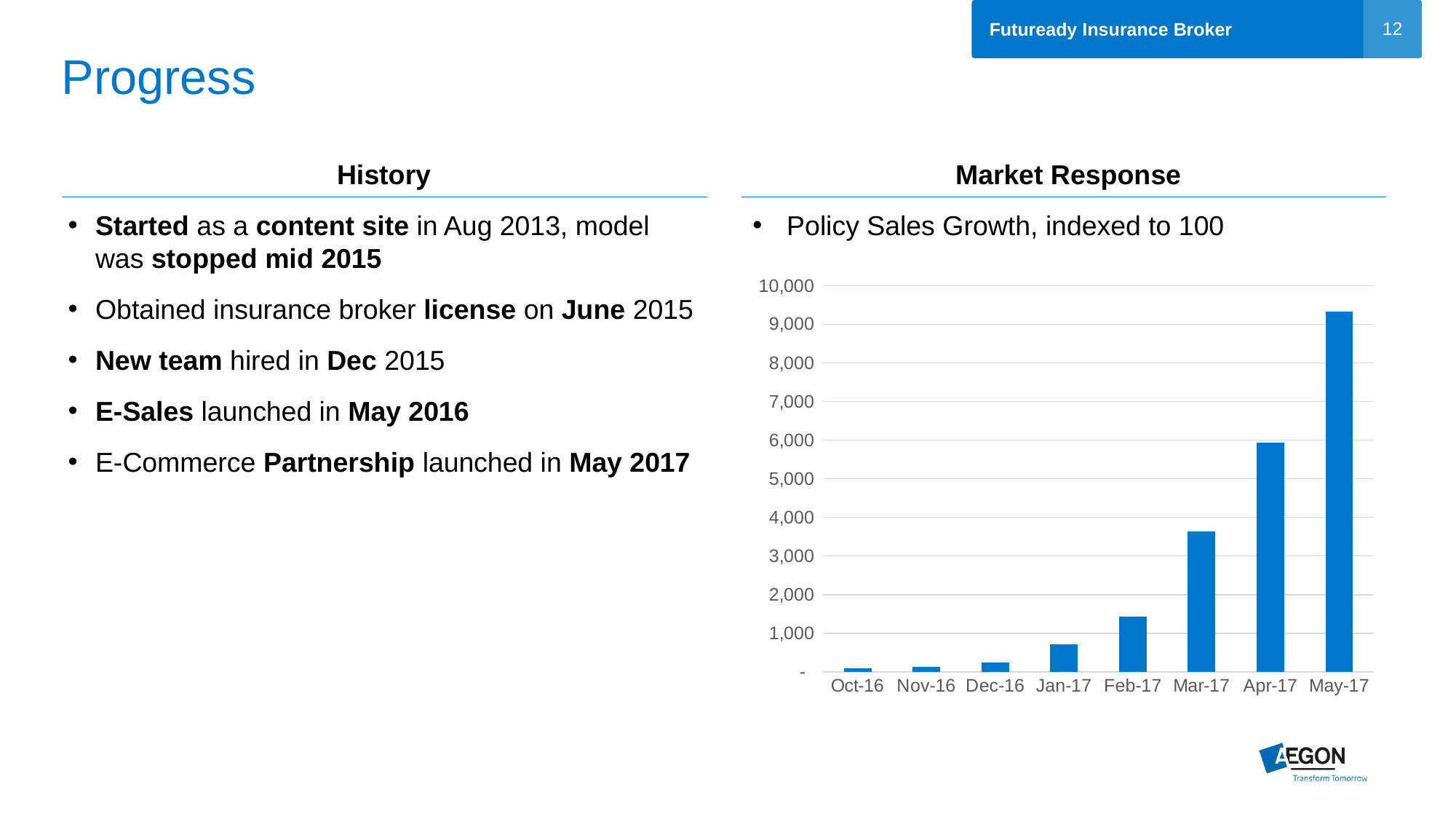
How many months are shown on the x axis of the Policy Sales Growth chart? 8 Is the value for Feb-17 greater or less than 1,000? greater Is the value for May-17 greater or less than 9,000? greater Is the value for Mar-17 greater or less than 4,000? less Which month has the highest value in the Policy Sales Growth chart? May-17 What is the base index value stated for the Policy Sales Growth chart? 100 Which is larger, the value for Mar-17 or the value for Apr-17? Apr-17 What kind of chart is shown under Market Response? bar chart Do the values rise or fall from Oct-16 to May-17? rise Which is larger, the value for Dec-16 or the value for Feb-17? Feb-17